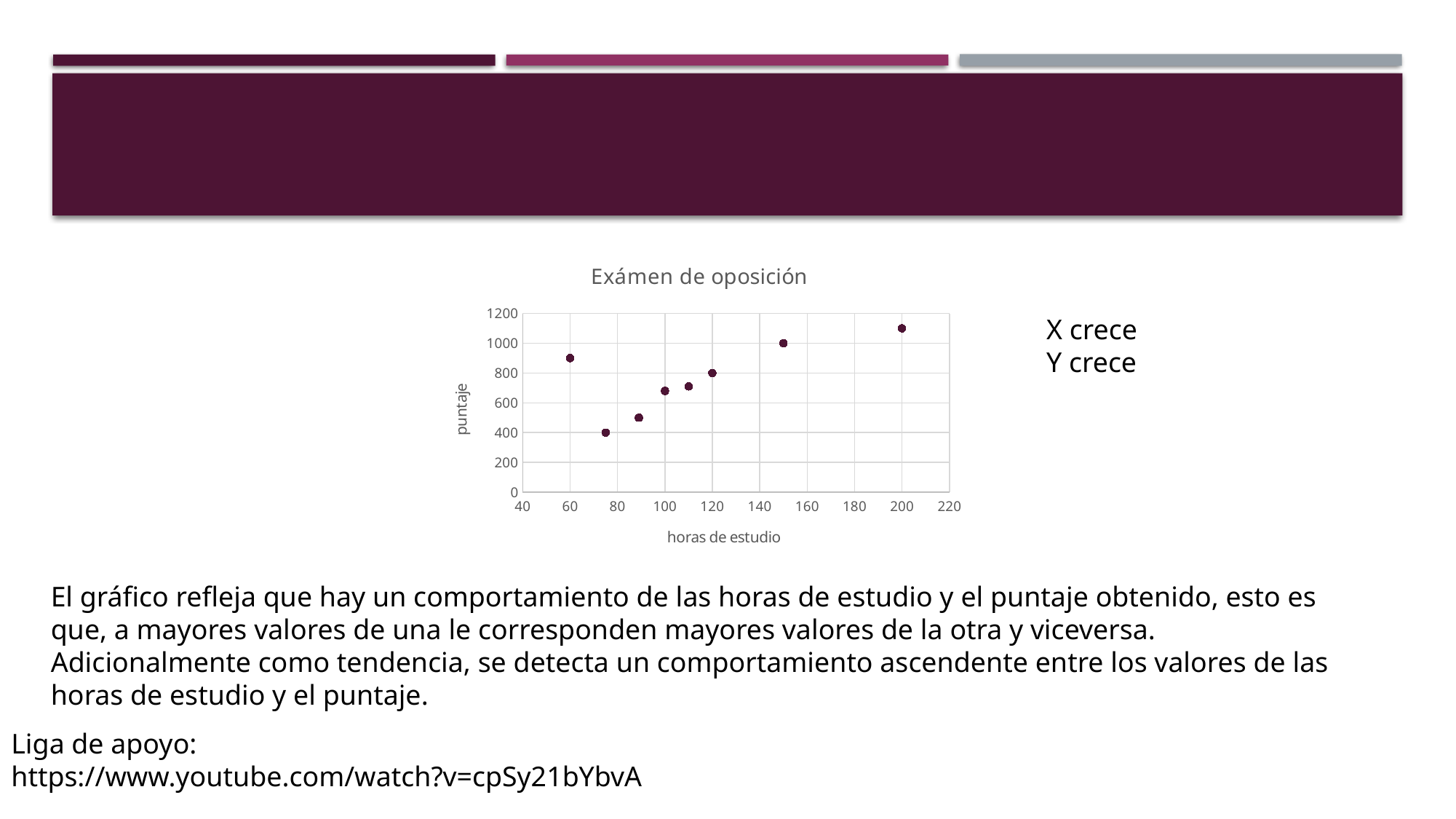
What is the puntaje for the point at 120 horas de estudio? 800 How many data points are plotted in the chart? 8 Do the puntaje values generally rise or fall as horas de estudio increase? rise What type of chart is shown on the slide? scatter chart What is the label of the x axis of the chart? horas de estudio Which point has the higher puntaje, the one at 120 horas de estudio or the one at 150 horas de estudio? 150 horas de estudio What is the title of the chart? Exámen de oposición Is the puntaje for the point at 100 horas de estudio greater or less than 600? greater What is the puntaje for the point at 150 horas de estudio? 1000 Is the puntaje for the point at 200 horas de estudio greater or less than 1000? greater Is the puntaje for the point at 60 horas de estudio greater or less than 800? greater At how many horas de estudio is the point with the highest puntaje? 200